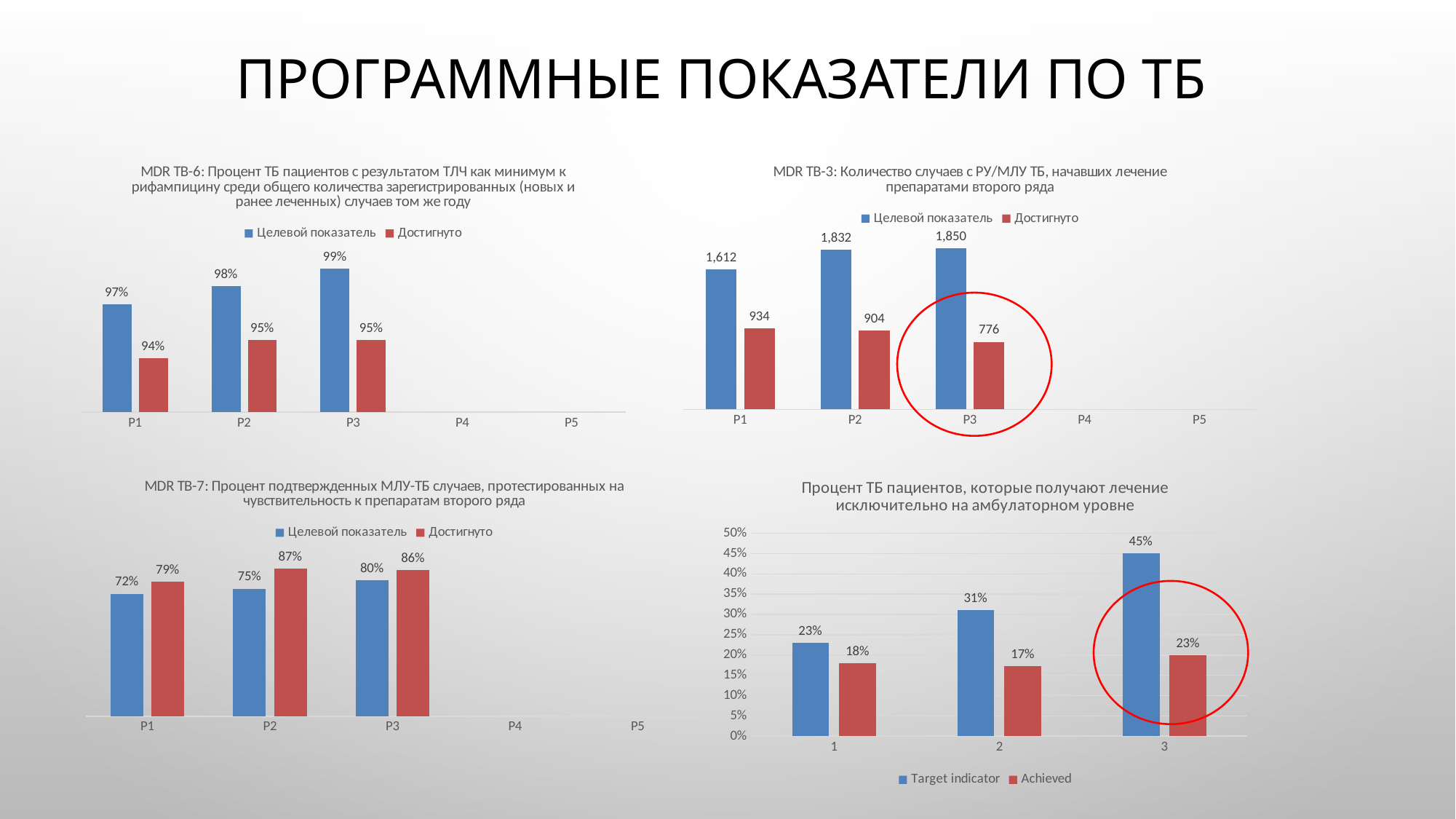
In the bottom-left chart (MDR TB-7), which is larger for P1: Целевой показатель or Достигнуто? Достигнуто In the top-right chart (MDR TB-3), which period has the lowest Достигнуто value? P3 In the top-right chart (MDR TB-3), what is the Целевой показатель value for P2? 1,832 In the bottom-right chart (outpatient treatment), which category has the highest Achieved value? 3 In the bottom-left chart (MDR TB-7), what is the Достигнуто value for P2? 87% How many series does the legend of the bottom-right chart list? 2 In the top-left chart (MDR TB-6), what is the difference between the Целевой показатель and Достигнуто values for P1? 3% In the top-left chart (MDR TB-6), what is the Достигнуто value for P3? 95% In the bottom-right chart (outpatient treatment), what is the Target indicator value for category 3? 45% In the top-right chart (MDR TB-3), what is the difference between the Целевой показатель and Достигнуто values for P3? 1,074 In the bottom-right chart (outpatient treatment), how many categories are shown on the x axis? 3 In the top-right chart (MDR TB-3), do the Достигнуто values rise or fall from P1 to P3? fall